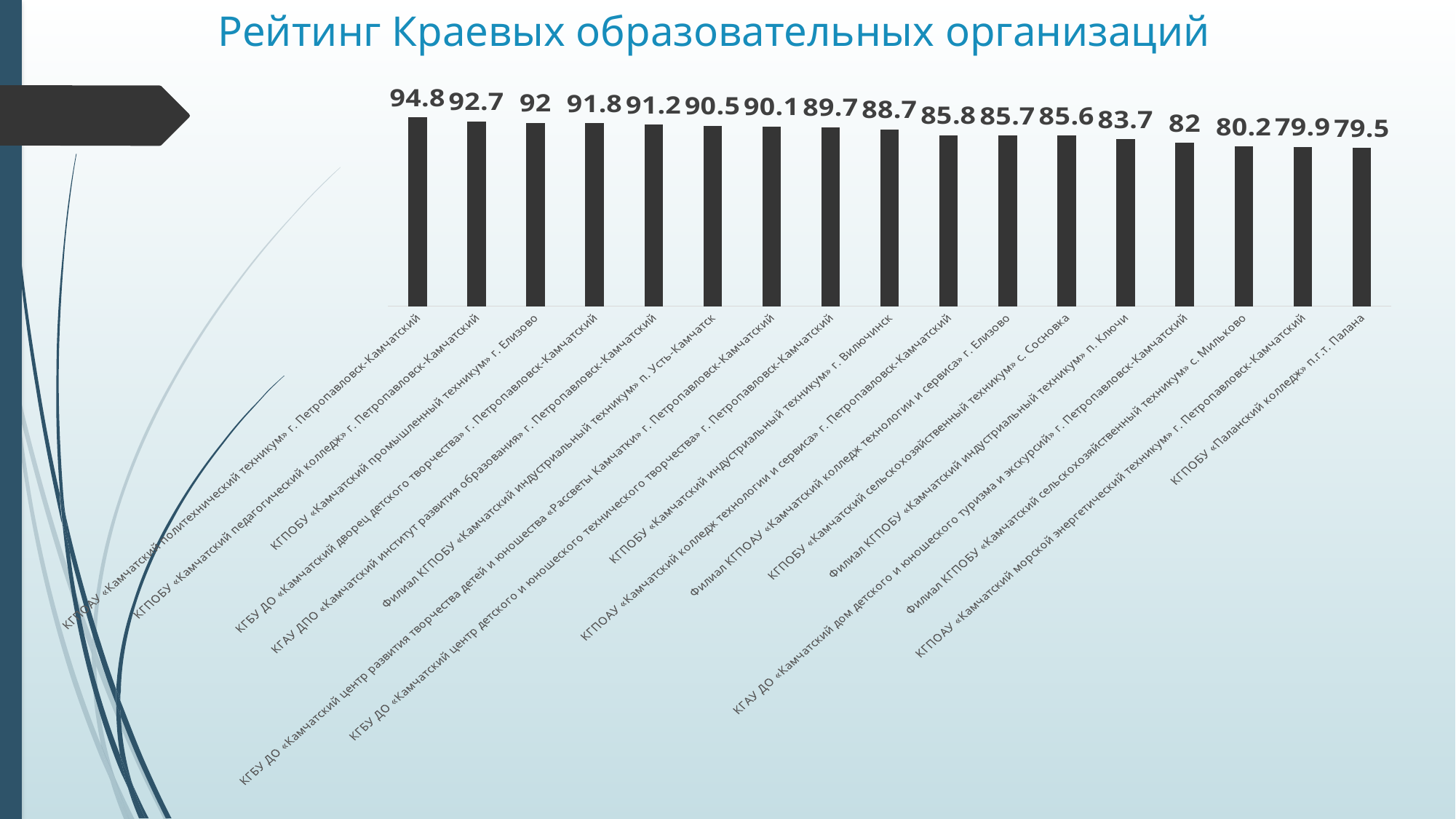
Do the values rise or fall from left to right along the x axis? fall What type of chart is shown on the slide? bar chart Which organisation has the highest rating in the chart? КГПОАУ «Камчатский политехнический техникум» г. Петропавловск-Камчатский What is the value for КГПОБУ «Паланский колледж» п.г.т. Палана? 79.5 Which organisation has the lowest rating in the chart? КГПОБУ «Паланский колледж» п.г.т. Палана What is the difference between the highest value (94.8) and the lowest value (79.5) in the chart? 15.3 What is the value for КГПОАУ «Камчатский политехнический техникум» г. Петропавловск-Камчатский? 94.8 Which has a higher value: КГПОБУ «Камчатский промышленный техникум» г. Елизово or Филиал КГПОБУ «Камчатский индустриальный техникум» п. Ключи? КГПОБУ «Камчатский промышленный техникум» г. Елизово What is the value for КГАУ ДО «Камчатский дом детского и юношеского туризма и экскурсий» г. Петропавловск-Камчатский? 82 How many organisations (bars) are shown in the chart? 17 What is the value for КГПОБУ «Камчатский индустриальный техникум» г. Вилючинск? 88.7 What is the chart's title? Рейтинг Краевых образовательных организаций